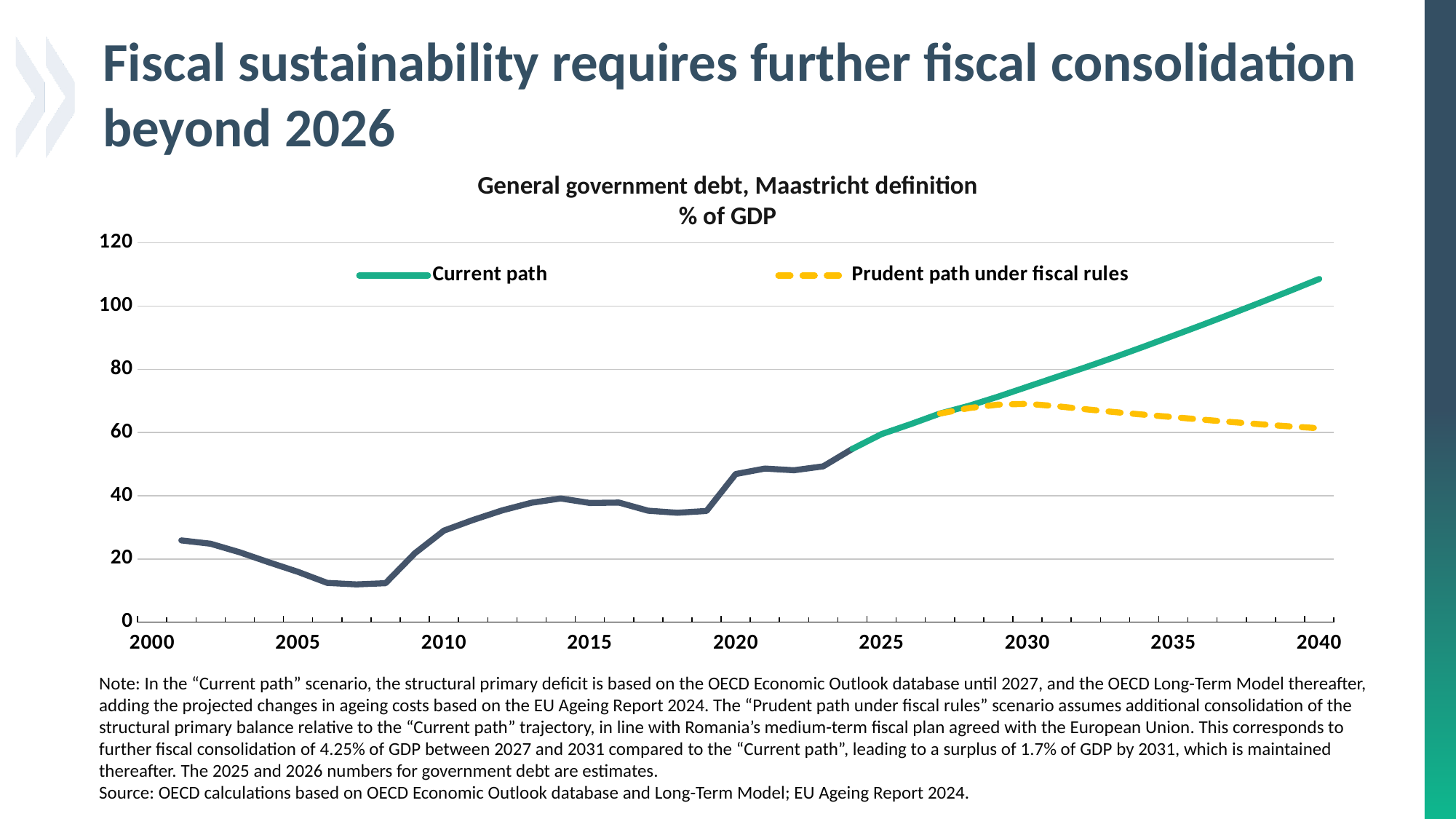
Is the government debt value in 2020 greater or less than 40? greater What is the title of the chart? General government debt, Maastricht definition % of GDP Does the Prudent path under fiscal rules rise or fall between 2030 and 2040? fall Is the value of the Current path in 2040 greater or less than 100? greater Is the value of the Prudent path under fiscal rules in 2040 greater or less than 80? less How many series does the legend list? 2 In 2040, which series has the higher value, Current path or Prudent path under fiscal rules? Current path Which series is drawn as a yellow dashed line? Prudent path under fiscal rules What kind of chart is shown on the slide? line chart Does the Current path rise or fall between 2025 and 2040? rise